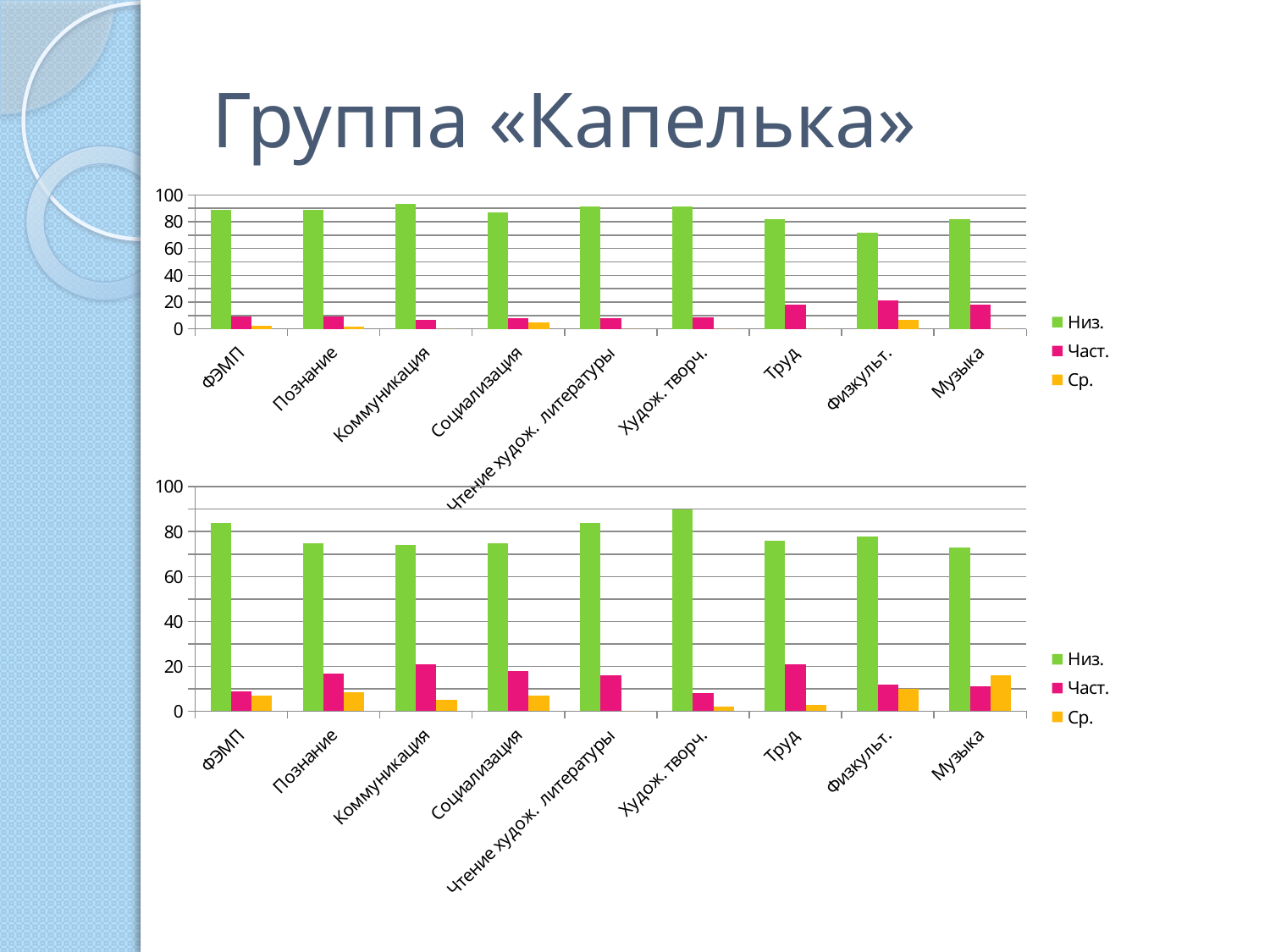
How many series does the legend of the top chart list? 3 In the bottom chart, is the Низ. value for Музыка greater or less than 80? less What are the three legend entries of the bottom chart? Низ., Част., Ср. What kind of chart is the top chart on the slide? bar chart In the bottom chart, which is larger for the Ср. series: Музыка or Худож. творч.? Музыка In the top chart, which category has the lowest value for the Низ. series? Физкульт. In the bottom chart, which category has the highest value for the Низ. series? Худож. творч. In the top chart, is the Низ. value for Физкульт. greater or less than 80? less In the top chart, which is larger for the Низ. series: Труд or Физкульт.? Труд In the top chart, is the Низ. value for Коммуникация greater or less than 80? greater How many categories are shown along the x axis of the bottom chart? 9 In the bottom chart, which category has the highest value for the Ср. series? Музыка